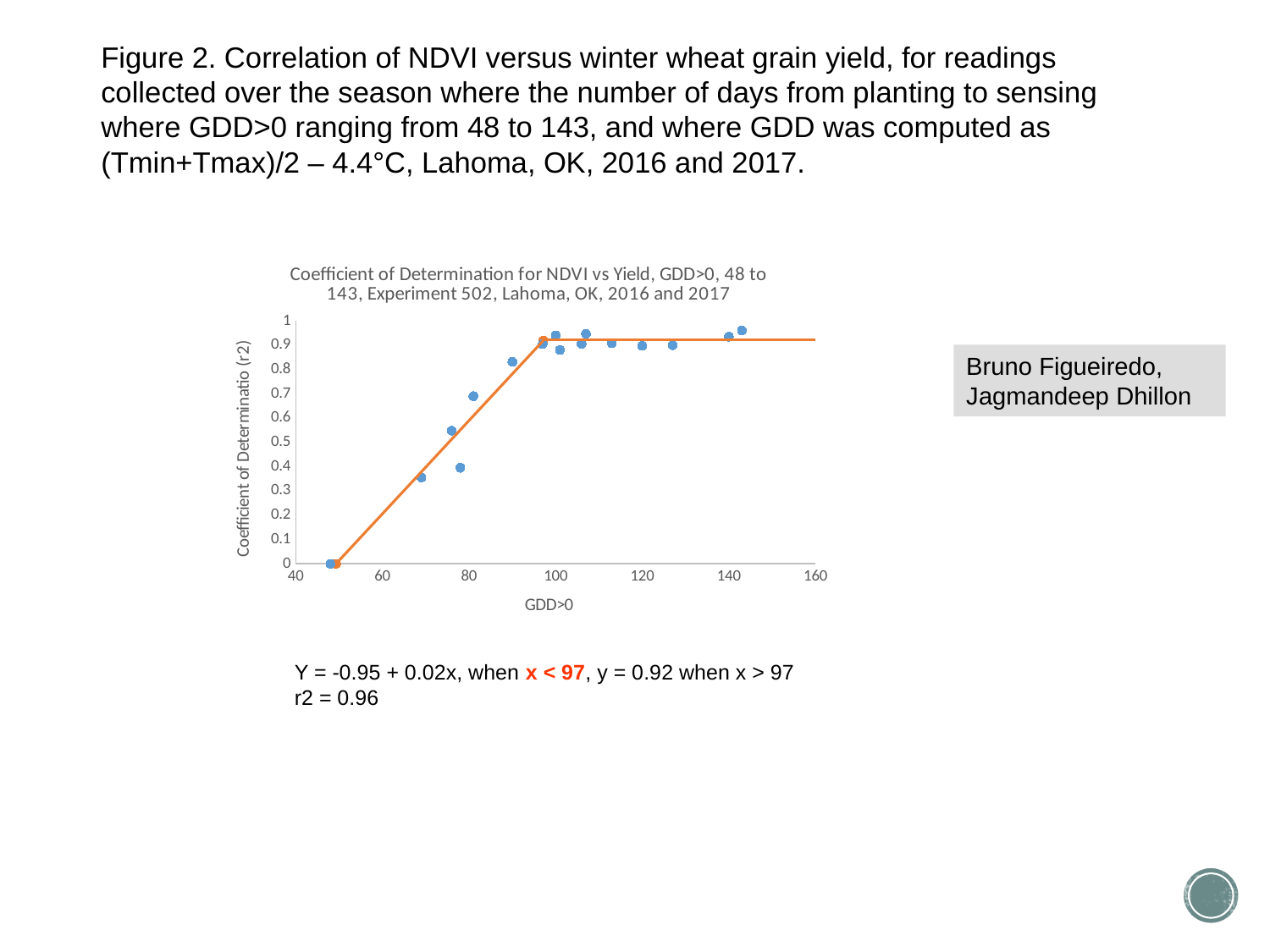
What is the highest value shown on the y axis of the chart? 1 What is the label of the x axis of the chart? GDD>0 Is the r2 value of the plotted point near GDD>0 = 90 greater or less than 0.7? greater What kind of chart is shown on the slide? Scatter chart What is the title of the chart? Coefficient of Determination for NDVI vs Yield, GDD>0, 48 to 143, Experiment 502, Lahoma, OK, 2016 and 2017 Is the highest plotted r2 value greater or less than 0.9? greater Do the plotted r2 values generally rise or fall as GDD>0 increases from 40 to 100? Rise What is the highest value shown on the x axis of the chart? 160 What r2 value is reported for the fitted model below the chart? 0.96 Is the leftmost plotted point's r2 value greater or less than 0.1? less According to the fitted equation below the chart, what is the value of y when x > 97? 0.92 Which plotted point has the lower r2 value: the one near GDD>0 = 69 or the one near GDD>0 = 90? The one near GDD>0 = 69